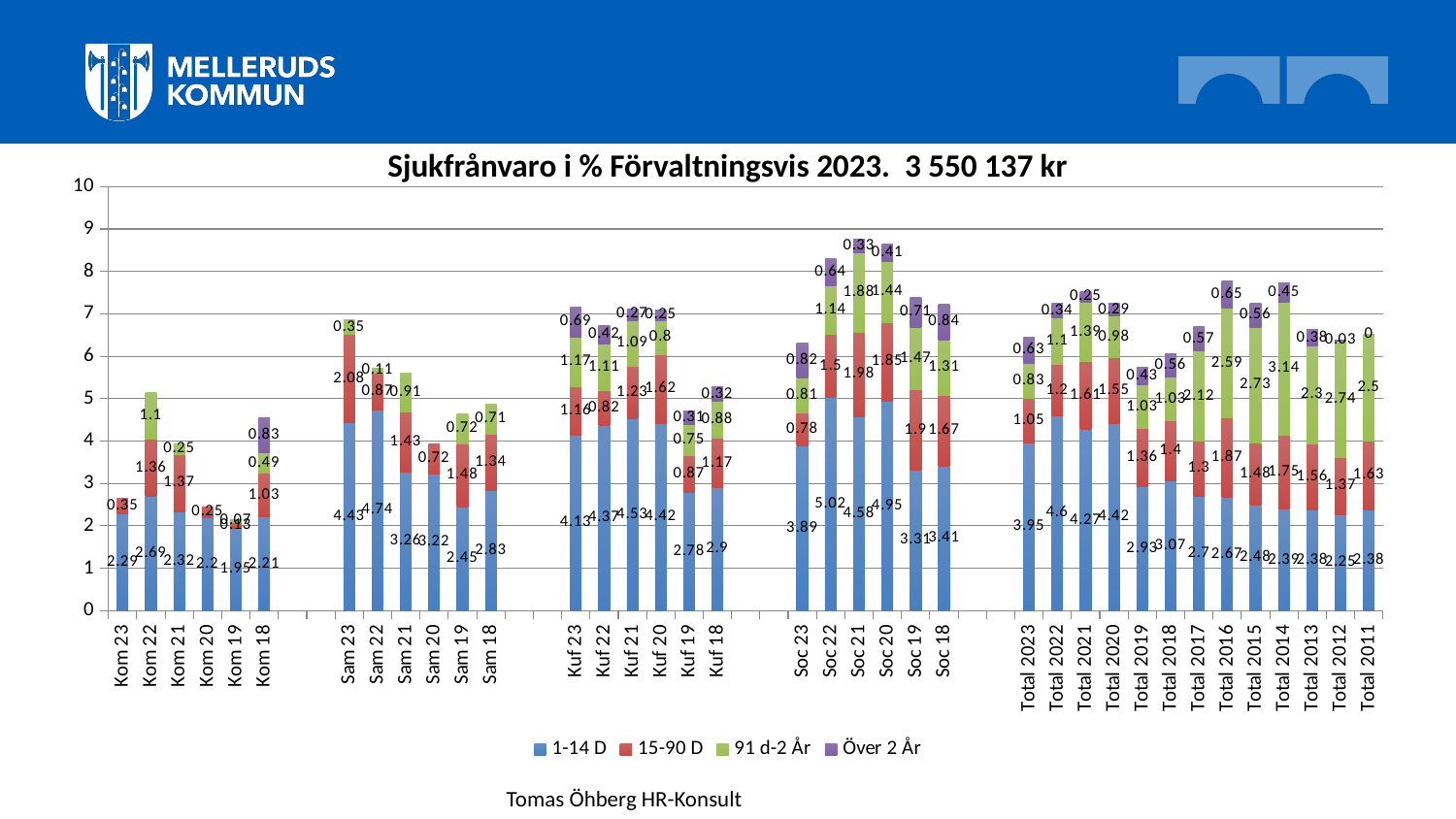
What is the Över 2 År value for Kuf 23? 0.69 What is the 15-90 D value for Sam 23? 2.08 What kind of chart is shown on the slide? Stacked bar chart Which category has the lowest total bar? Kom 19 What is the title of the chart? Sjukfrånvaro i % Förvaltningsvis 2023. 3 550 137 kr How many series does the legend list? 4 What is the 91 d-2 År value for Total 2014? 3.14 What is the 1-14 D value for Soc 22? 5.02 Is the total bar for Soc 21 greater or less than 8? greater Which has the larger 1-14 D value, Sam 22 or Sam 21? Sam 22 What is the total of the stacked bar for Kuf 23? 7.15 What is the difference between the 1-14 D values for Soc 22 and Soc 23? 1.13